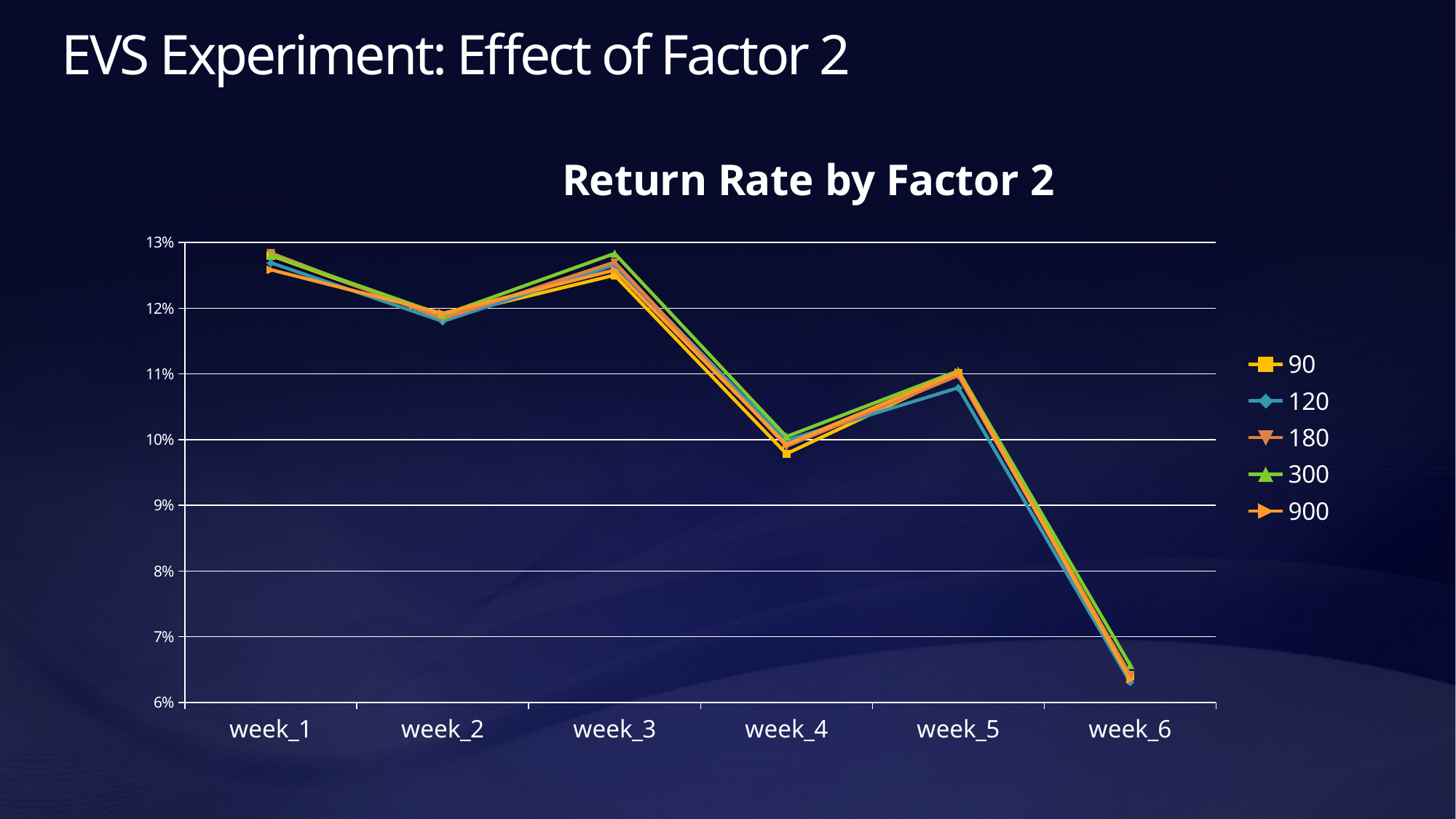
Is the value for series 90 at week_1 greater or less than 12%? greater What kind of chart is shown on the slide? line chart Which series are listed in the legend? 90, 120, 180, 300, 900 Overall, do the return rates rise or fall from week_1 to week_6? fall For series 90, is the value at week_1 or at week_6 larger? week_1 How many weeks are shown on the x axis? 6 Is the value for series 300 at week_6 greater or less than 7%? less Is the value for series 900 at week_3 greater or less than 12%? greater How many series does the legend list? 5 For series 300, which week has the lowest return rate? week_6 What is the title of the chart? Return Rate by Factor 2